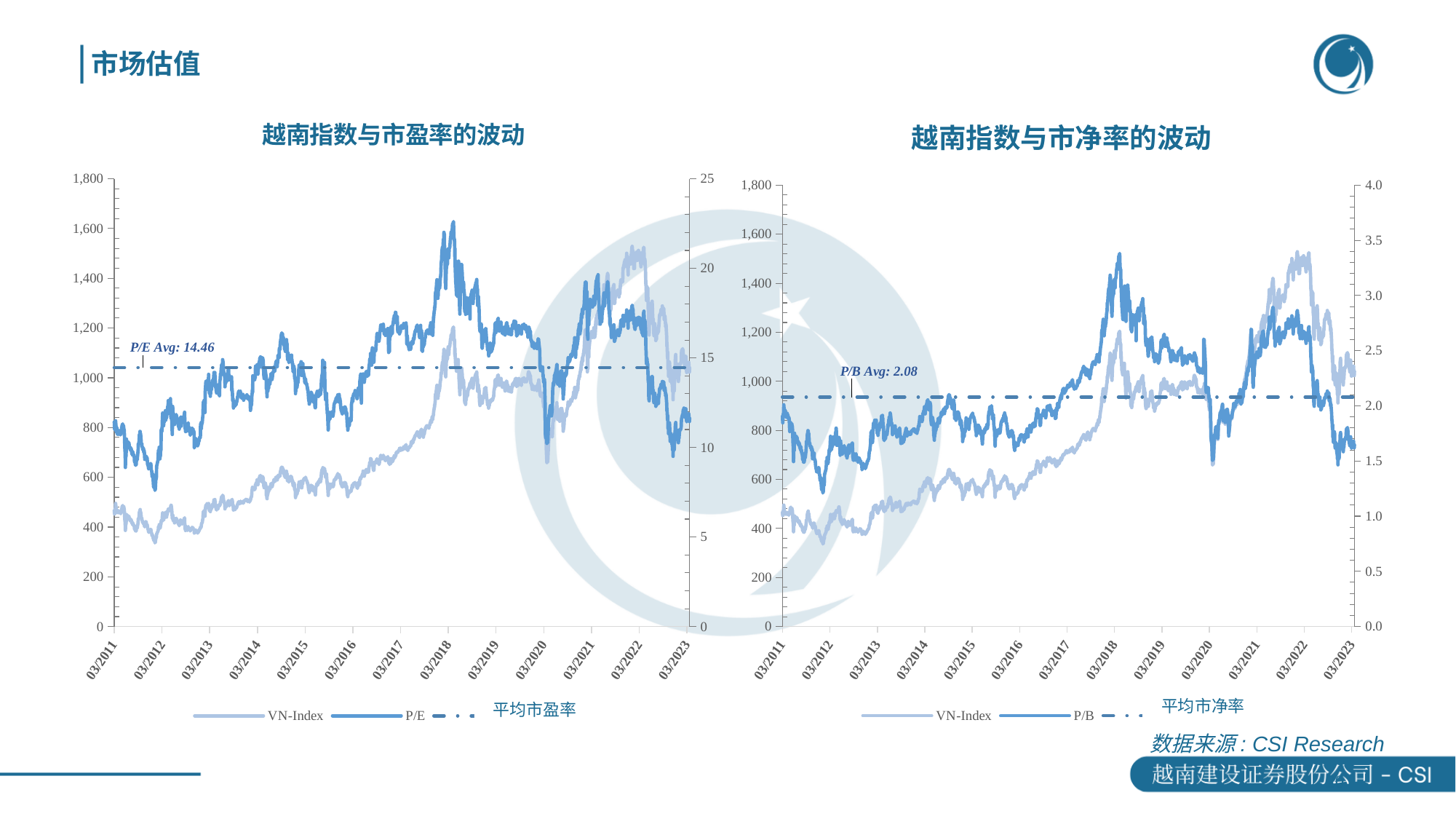
In the right chart (越南指数与市净率的波动), what is the average P/B value printed on the chart? 2.08 What kind of chart is the left chart titled 越南指数与市盈率的波动? Line chart In the left chart (越南指数与市盈率的波动), is the peak P/E value around 03/2018 greater or less than 20? greater What is the title of the right chart on the slide? 越南指数与市净率的波动 How many series does the legend of the right chart (越南指数与市净率的波动) list? 3 In the left chart (越南指数与市盈率的波动), what is the average P/E value printed on the chart? 14.46 How many series does the legend of the left chart (越南指数与市盈率的波动) list? 3 In the right chart (越南指数与市净率的波动), is the P/B value at 03/2023 greater or less than 2.0? less In the left chart (越南指数与市盈率的波动), does the VN-Index generally rise or fall from 03/2011 to 03/2018? Rise In the left chart (越南指数与市盈率的波动), is the VN-Index value at 03/2012 greater or less than 600? less How many date labels are shown on the x axis of the right chart (越南指数与市净率的波动)? 13